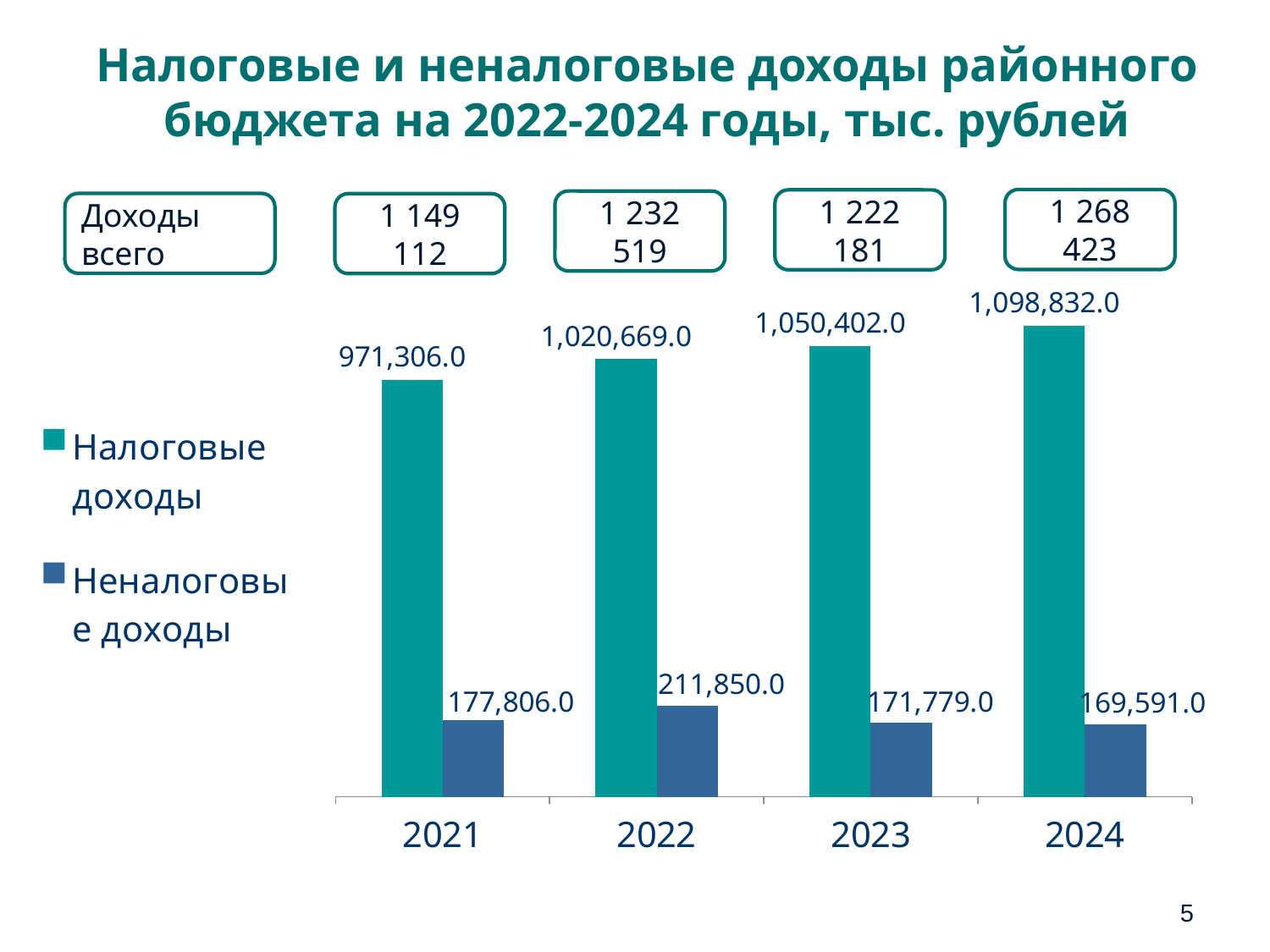
What is the value of Неналоговые доходы for 2022? 211,850.0 Do Налоговые доходы rise or fall from 2021 to 2024? rise How many series does the legend list? 2 What is the value of Налоговые доходы for 2021? 971,306.0 Which is larger: Неналоговые доходы in 2023 or in 2024? 2023 How many years are shown on the x axis? 4 In which year are Неналоговые доходы the highest? 2022 In which year are Налоговые доходы the lowest? 2021 What is the difference between Налоговые доходы in 2024 and in 2021? 127,526.0 Which series is shown in teal? Налоговые доходы What kind of chart is shown on the slide? bar chart What is the value of Налоговые доходы for 2024? 1,098,832.0